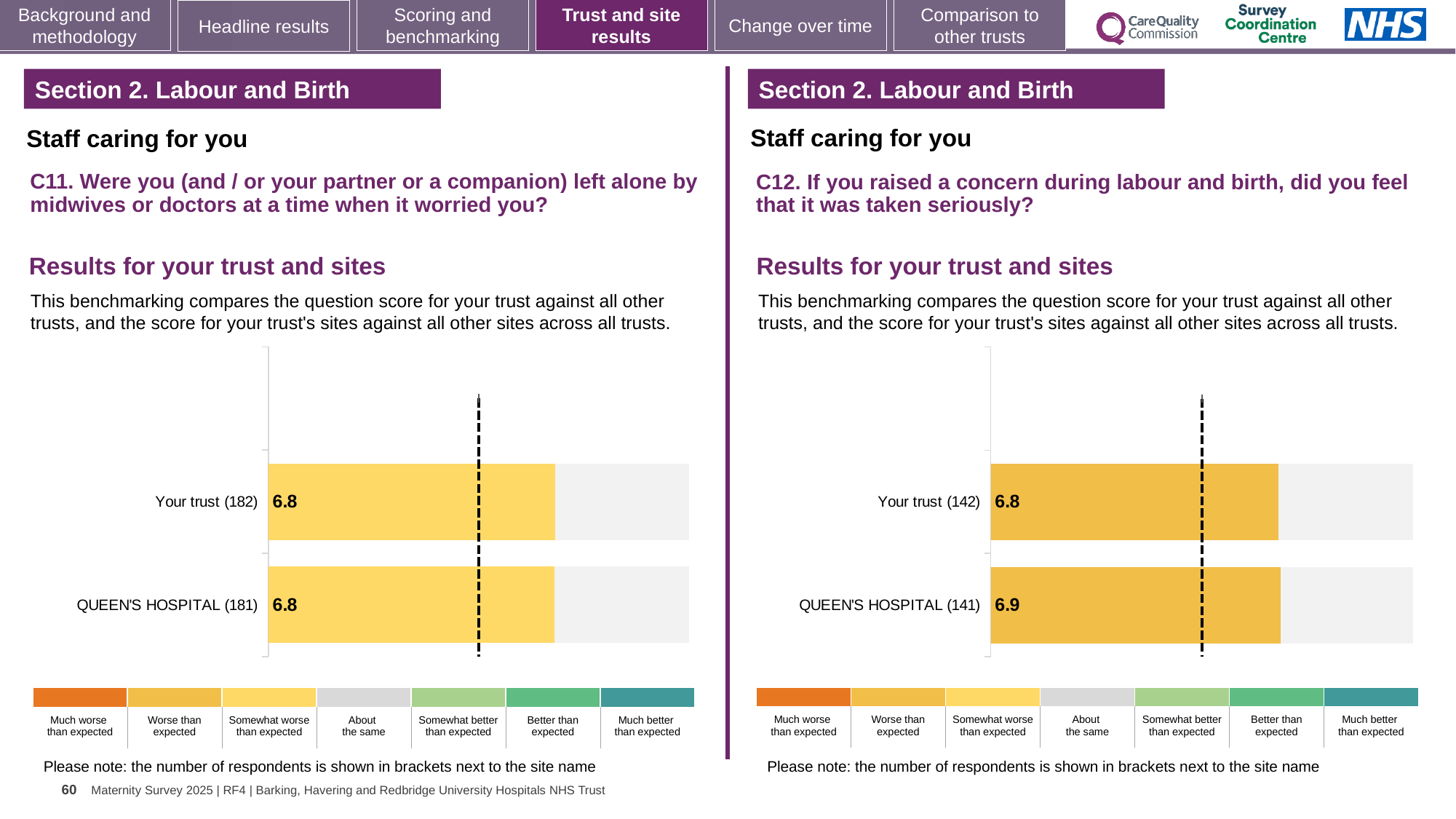
What type of chart is used for the C11 results on the left? Bar chart In the C12 chart on the right, what is the difference between the QUEEN'S HOSPITAL score and the Your trust score? 0.1 How many respondents are shown in brackets for Your trust in the C12 chart on the right? 142 In the C11 chart on the left, what is the score for Your trust (182)? 6.8 How many bars are plotted in the C11 chart on the left? 2 How many benchmark categories does the colour key below the C11 chart on the left list? 7 In the C11 chart on the left, what is the difference between the Your trust score and the QUEEN'S HOSPITAL score? 0 In the C12 chart on the right, what is the score for QUEEN'S HOSPITAL (141)? 6.9 In the C12 chart on the right, which has the higher score, Your trust or QUEEN'S HOSPITAL? QUEEN'S HOSPITAL How many bars are plotted in the C12 chart on the right? 2 In the C12 chart on the right, what is the score for Your trust (142)? 6.8 In the C11 chart on the left, what is the score for QUEEN'S HOSPITAL (181)? 6.8